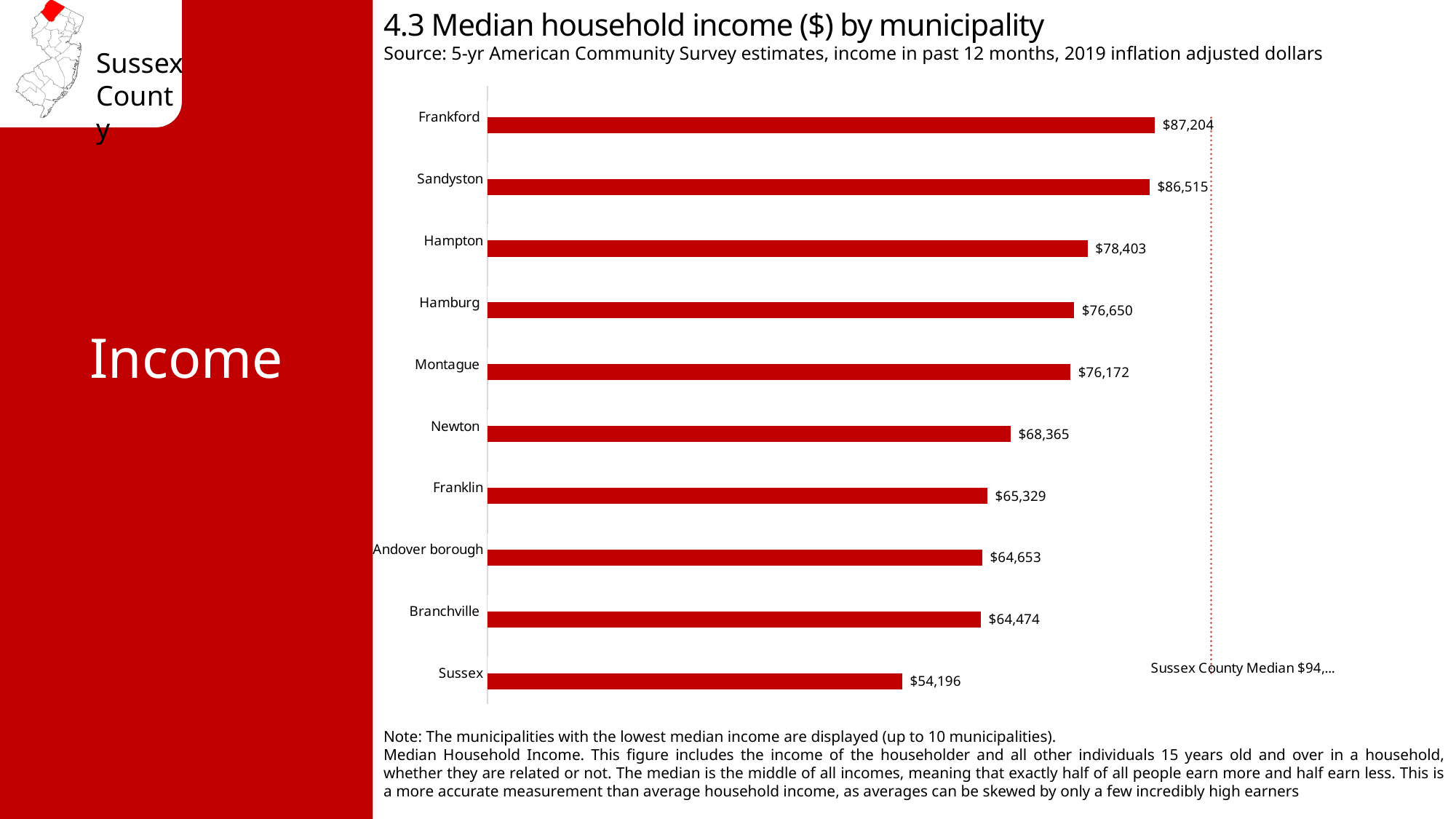
How many municipalities are shown on the chart? 10 What is the difference between the median household income of Frankford and Sandyston? $689 What is the median household income for Andover borough? $64,653 What is the median household income for Frankford? $87,204 Which has a higher median household income, Hamburg or Montague? Hamburg What does the dotted vertical line on the chart represent? Sussex County Median What type of chart is used to show median household income by municipality? Bar chart Which municipality has the highest median household income shown on the chart? Frankford What is the median household income for Newton? $68,365 Which municipality has the lowest median household income shown on the chart? Sussex What is the difference between the median household income of Hampton and Sussex? $24,207 What is the median household income for Sussex? $54,196